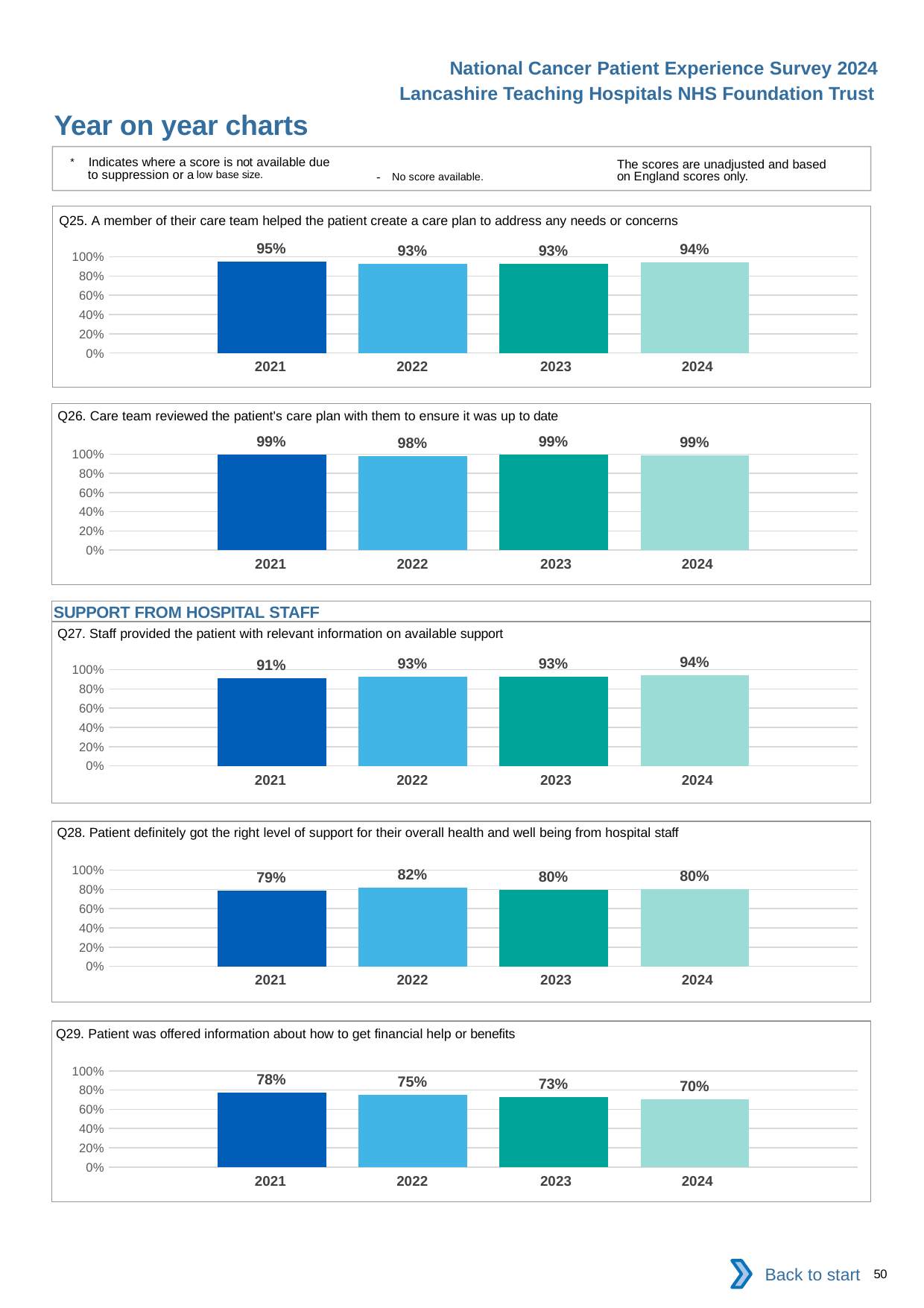
In the Q25 chart, what is the value for 2021? 95% In the Q26 chart, which year has the lowest value? 2022 What kind of chart is the Q26 chart? bar chart In the Q28 chart, is the value for 2021 larger or smaller than the value for 2022? smaller In the Q29 chart, do the values rise or fall from 2021 to 2024? fall In the Q27 chart, what is the difference between the 2024 value and the 2021 value? 3% In the Q29 chart, what is the difference between the 2021 value and the 2024 value? 8% In the Q28 chart, which year has the highest value? 2022 How many years are shown in the Q25 chart? 4 What section heading appears above the Q27 chart? SUPPORT FROM HOSPITAL STAFF In the Q27 chart, what is the value for 2022? 93% In the Q29 chart, what is the value for 2024? 70%